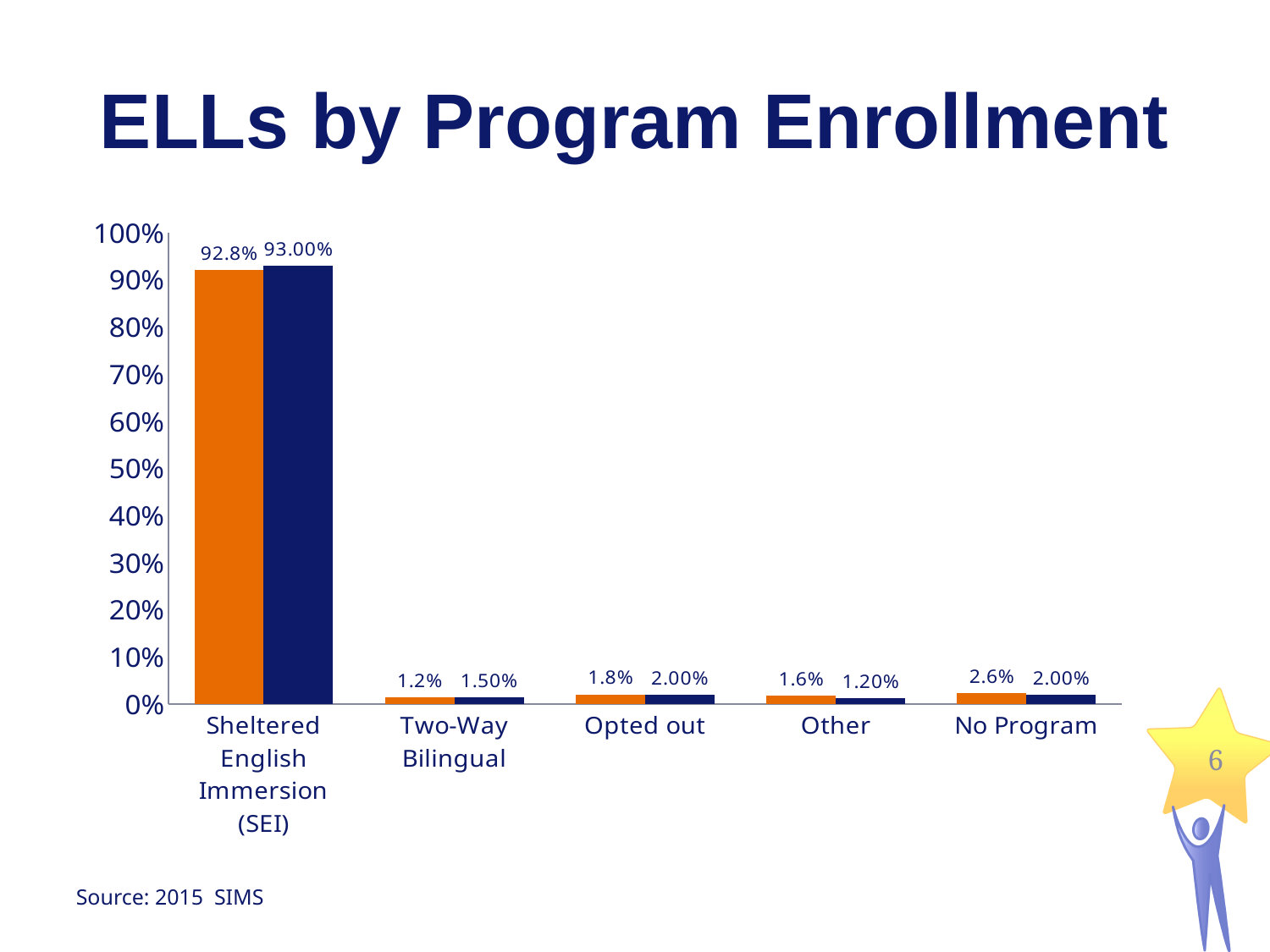
For No Program, which bar is larger, the orange or the dark blue? orange What is the difference between the dark blue and orange bars for Sheltered English Immersion (SEI)? 0.2% How many program categories are shown on the x axis? 5 What is the value of the orange bar for Sheltered English Immersion (SEI)? 92.8% Which category has the highest value for the orange bars? Sheltered English Immersion (SEI) Which category has the lowest value for the orange bars? Two-Way Bilingual Which category has the lowest value for the dark blue bars? Other What type of chart is shown on the slide? bar chart What is the value of the dark blue bar for Other? 1.20% What is the value of the orange bar for No Program? 2.6% Is the orange bar for Sheltered English Immersion (SEI) greater or less than 90%? greater What is the value of the dark blue bar for Sheltered English Immersion (SEI)? 93.00%